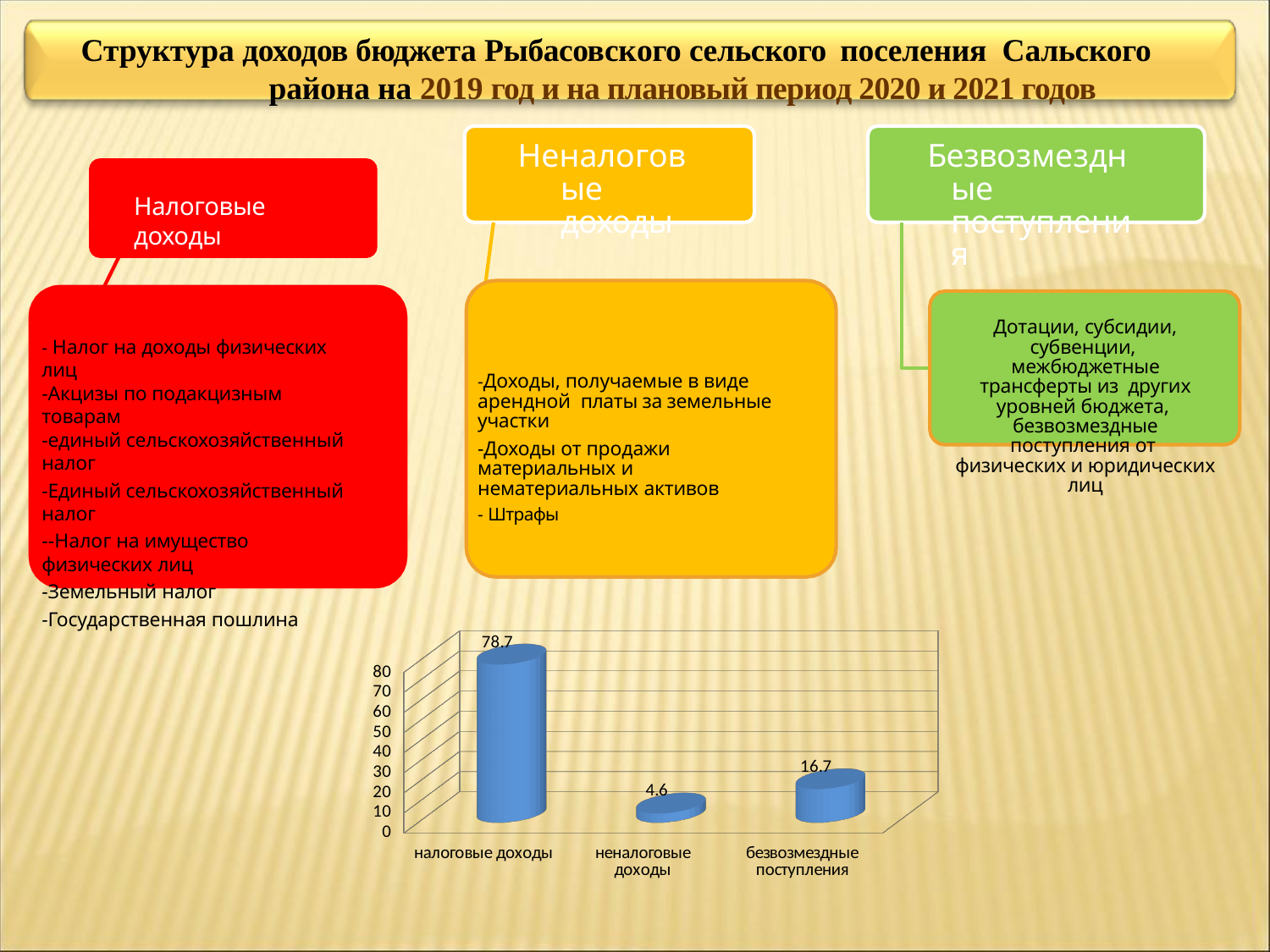
Which is larger, the value for безвозмездные поступления or the value for неналоговые доходы? безвозмездные поступления Which category has the lowest value in the chart? неналоговые доходы What is the value for неналоговые доходы in the chart? 4.6 Is the value for налоговые доходы greater or less than 70? greater What is the highest value shown on the vertical axis of the chart? 80 What is the difference between the values for безвозмездные поступления and неналоговые доходы? 12.1 What is the value for безвозмездные поступления in the chart? 16.7 Which category has the highest value in the chart? налоговые доходы What is the value for налоговые доходы in the chart? 78.7 What is the difference between the values for налоговые доходы and безвозмездные поступления? 62 How many categories are shown in the chart? 3 What kind of chart is shown on the slide? bar chart